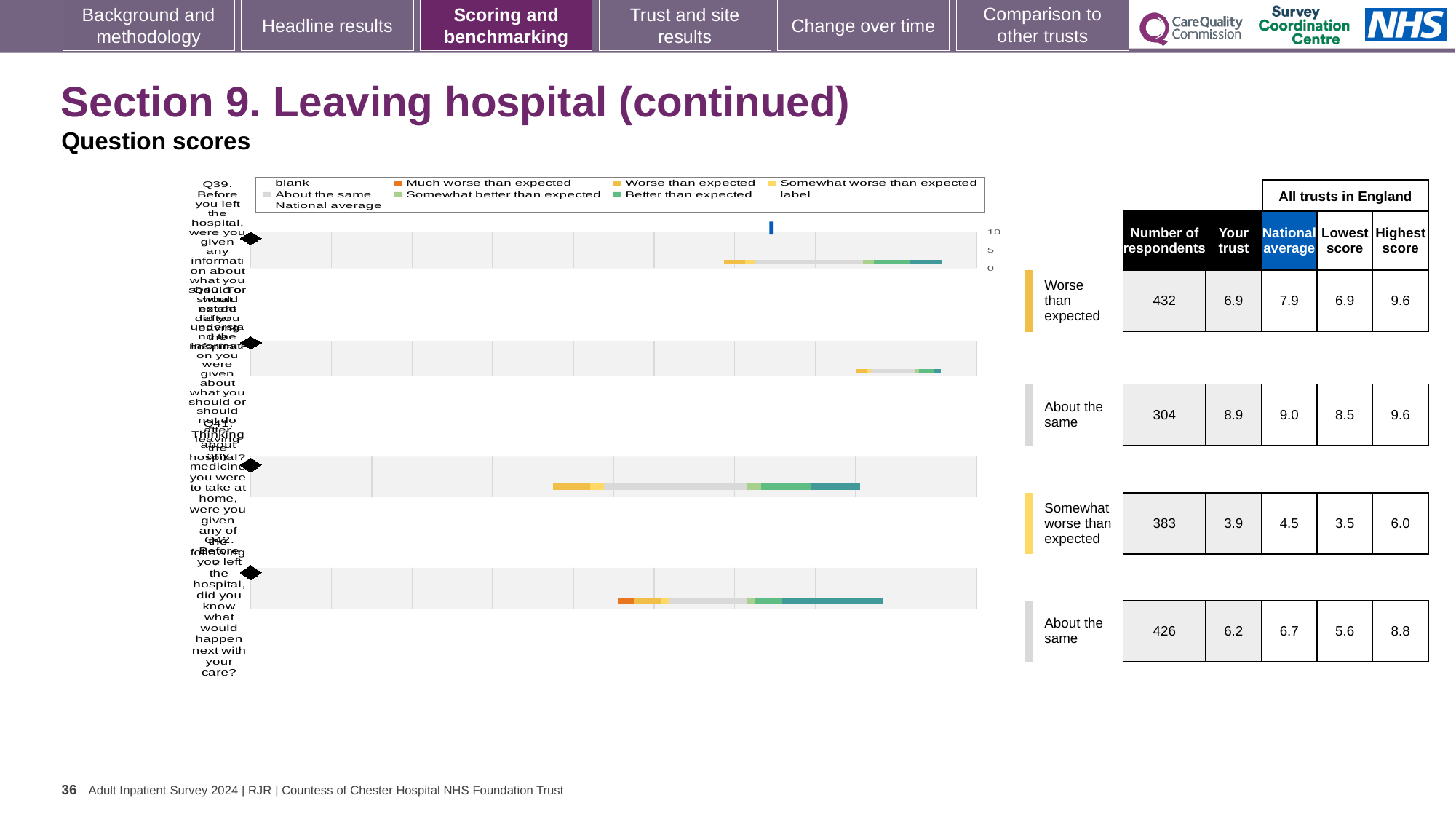
In the table, what is the national average for the first row rated 'About the same'? 9.0 What is the title of the column group above 'National average', 'Lowest score' and 'Highest score' in the table? All trusts in England In the table, which row has the lowest 'Your trust' score? Somewhat worse than expected (3.9) In the table, what is the lowest score for the row rated 'Somewhat worse than expected'? 3.5 In the table, what is the difference between the national average and the 'Your trust' score for the row rated 'Worse than expected'? 1.0 What colour does the legend use for 'Much worse than expected'? orange In the table, for the first 'About the same' row, which is larger: the 'Your trust' score or the national average? National average In the table, what is the number of respondents for the row rated 'Worse than expected'? 432 How many question bars are plotted in the chart? 4 In the table, what is the 'Your trust' score for the row rated 'Somewhat worse than expected'? 3.9 What kind of chart is shown on the slide? bar chart In the table, what is the highest score for the last row (the second 'About the same' row)? 8.8